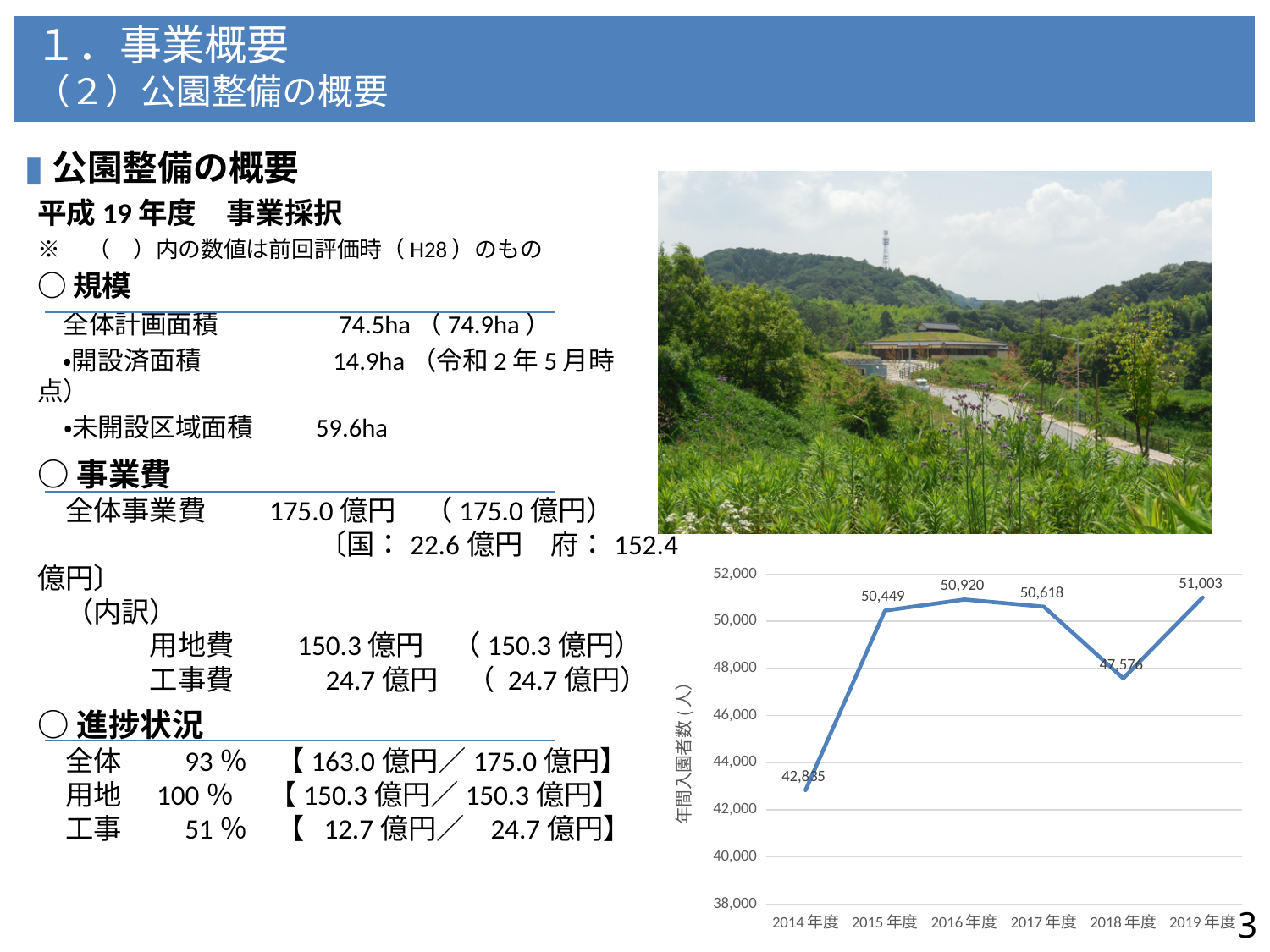
What type of chart is shown on the slide? line chart What is the label of the vertical axis of the line chart? 年間入園者数（人） What is the value for 2019年度 in the line chart? 51,003 What is the value for 2018年度 in the line chart? 47,576 What is the difference between the values for 2015年度 and 2014年度 in the line chart? 7,614 Which year has the highest value in the line chart? 2019年度 How many years are plotted on the x axis of the line chart? 6 What is the value for 2016年度 in the line chart? 50,920 What is the value for 2014年度 in the line chart? 42,835 Is the value for 2018年度 greater or less than 48,000? less Which is larger in the line chart, the value for 2017年度 or 2018年度? 2017年度 Which year has the lowest value in the line chart? 2014年度